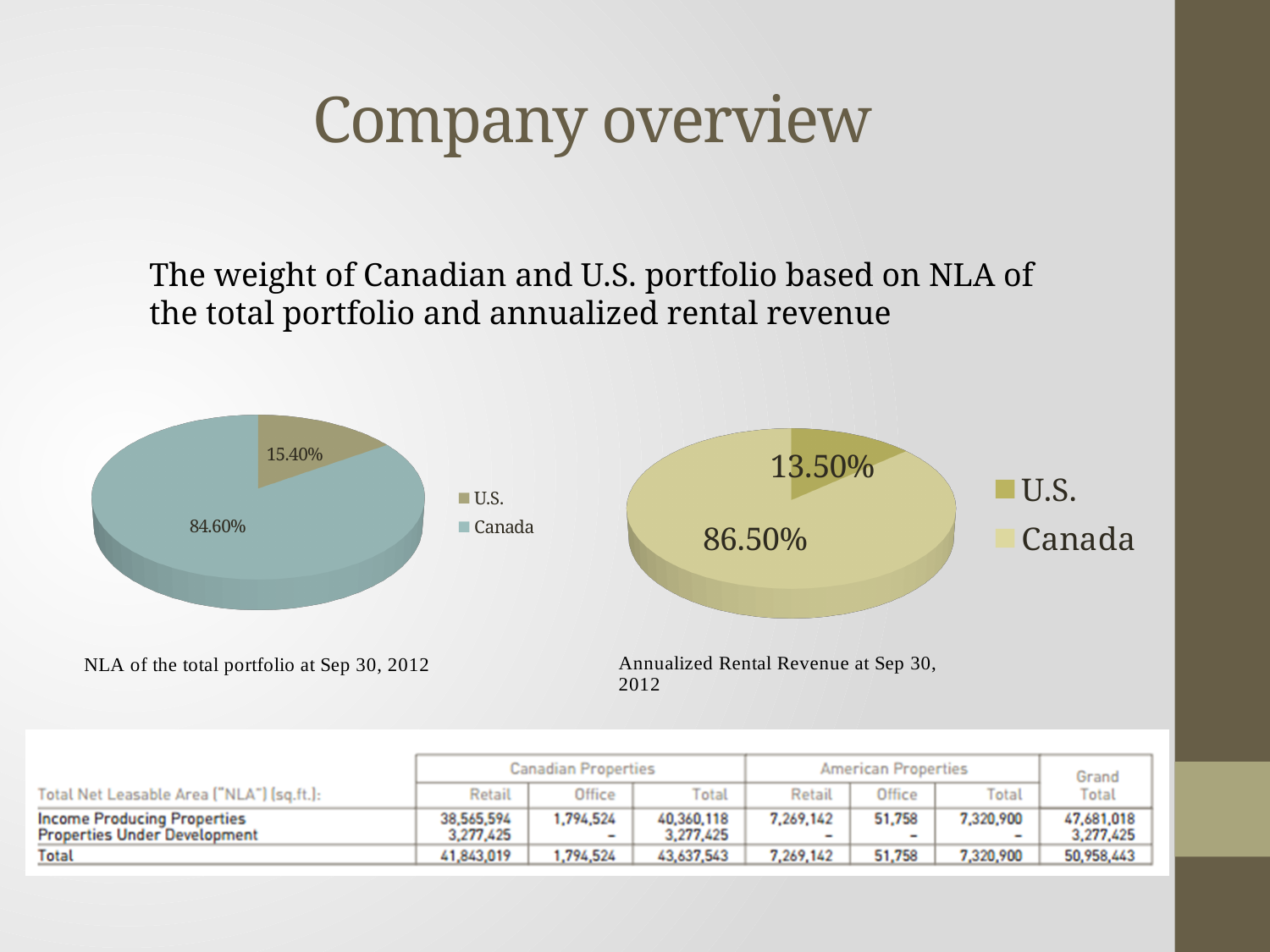
In the right pie chart (Annualized Rental Revenue), which category has the smallest slice? U.S. In the right pie chart (Annualized Rental Revenue), what is the difference between the Canada and U.S. shares? 73.00% In the right pie chart (Annualized Rental Revenue at Sep 30, 2012), what share does Canada hold? 86.50% What are the two legend entries in the right pie chart (Annualized Rental Revenue)? U.S. and Canada In the right pie chart (Annualized Rental Revenue at Sep 30, 2012), what share does the U.S. hold? 13.50% In the left pie chart (NLA of the total portfolio), what is the difference between the Canada and U.S. shares? 69.20% Is the U.S. share larger in the left pie chart (NLA) or in the right pie chart (Annualized Rental Revenue)? Left pie chart (NLA) What type of chart is used for the Annualized Rental Revenue at Sep 30, 2012? Pie chart In the left pie chart (NLA of the total portfolio at Sep 30, 2012), what share does Canada hold? 84.60% In the left pie chart (NLA of the total portfolio), which category has the largest slice? Canada In the left pie chart (NLA of the total portfolio at Sep 30, 2012), what share does the U.S. hold? 15.40% How many categories does the left pie chart (NLA of the total portfolio) show? 2